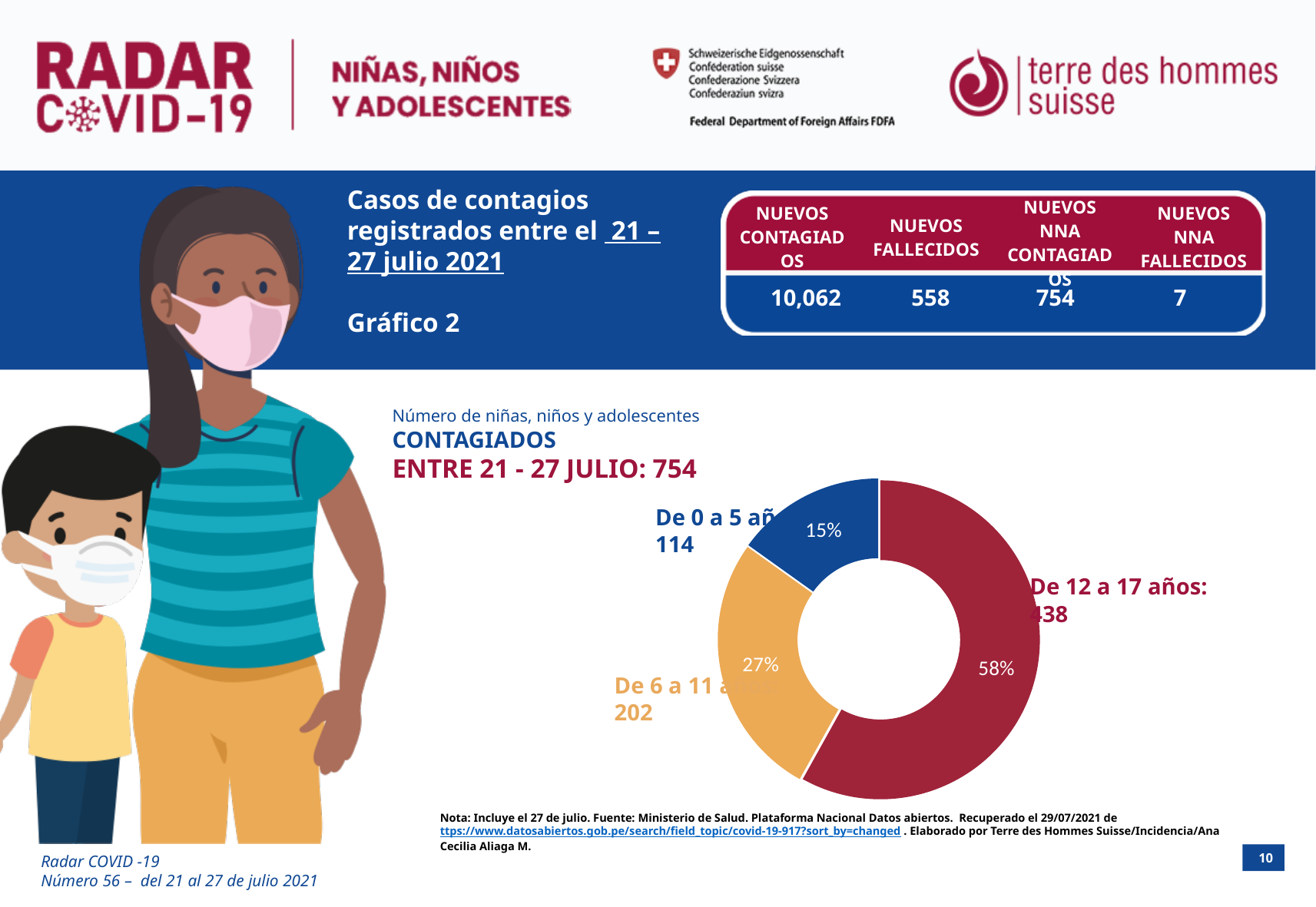
What is the number of contagiados for the group De 6 a 11 años? 202 Which age group has the lowest number of contagiados in the donut chart? De 0 a 5 años What is the difference in contagiados between De 12 a 17 años and De 6 a 11 años? 236 What percentage of the donut chart corresponds to De 12 a 17 años? 58% What is the number of contagiados for the group De 0 a 5 años? 114 Which age group has the highest number of contagiados in the donut chart? De 12 a 17 años What is the total number of niñas, niños y adolescentes contagiados shown in the chart title for 21 - 27 julio? 754 What percentage of the donut chart corresponds to De 0 a 5 años? 15% What kind of chart is shown on the slide? Donut (pie) chart What percentage of the donut chart corresponds to De 6 a 11 años? 27% How many age groups does the donut chart show? 3 What is the number of contagiados for the group De 12 a 17 años? 438